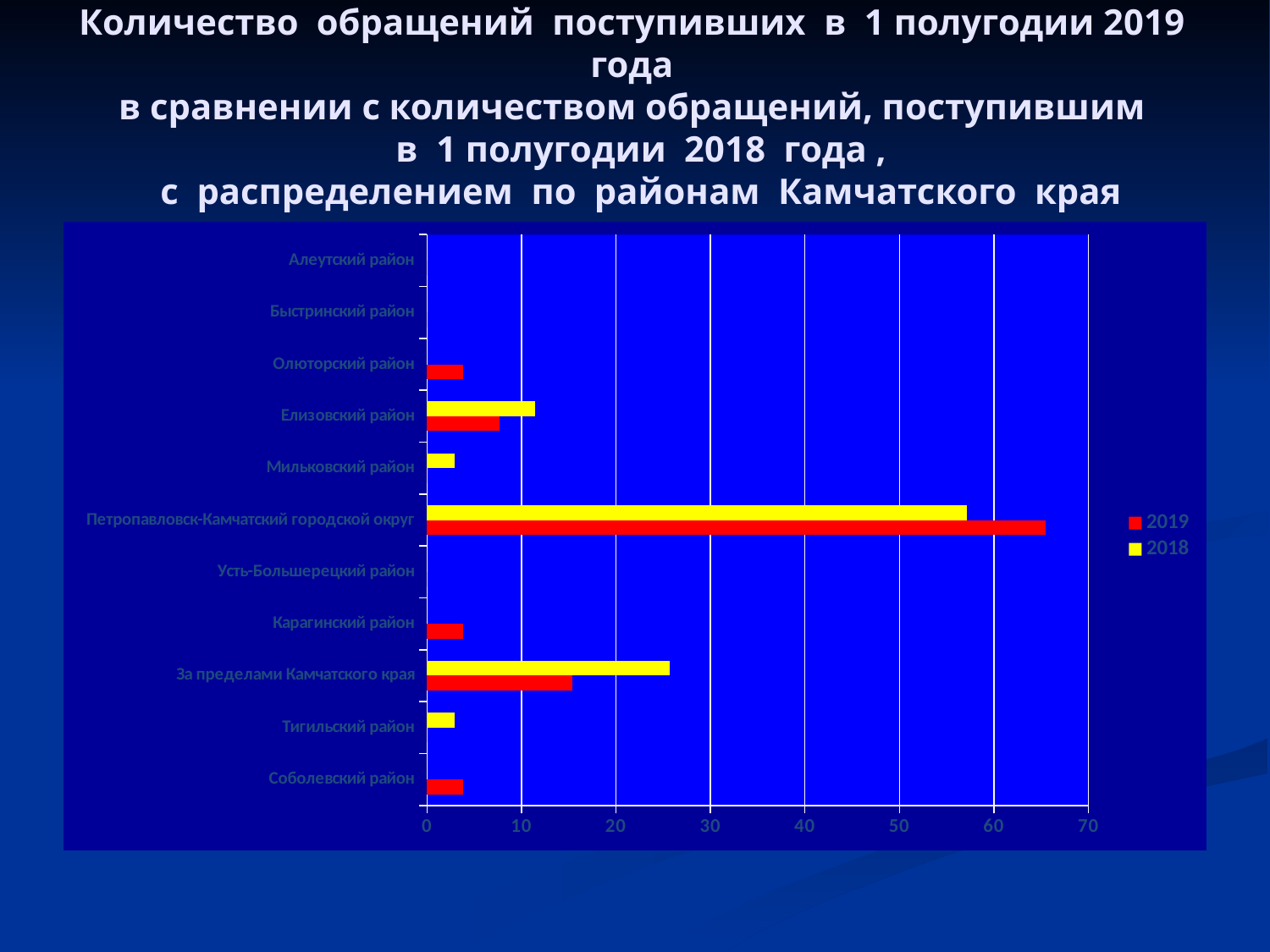
How many districts (categories) are listed on the vertical axis? 11 How many series does the legend list? 2 For Петропавловск-Камчатский городской округ, which series has the larger value, 2019 or 2018? 2019 Is the 2019 value for Петропавловск-Камчатский городской округ greater or less than 60? greater What colour represents the 2019 series in the legend? red For За пределами Камчатского края, which series has the larger value, 2019 or 2018? 2018 What kind of chart is shown on the slide? bar chart Is the 2019 value for Елизовский район greater or less than 10? less Is the 2018 value for За пределами Камчатского края greater or less than 20? greater Which category has the highest value for the 2018 series? Петропавловск-Камчатский городской округ Which category has the highest value for the 2019 series? Петропавловск-Камчатский городской округ